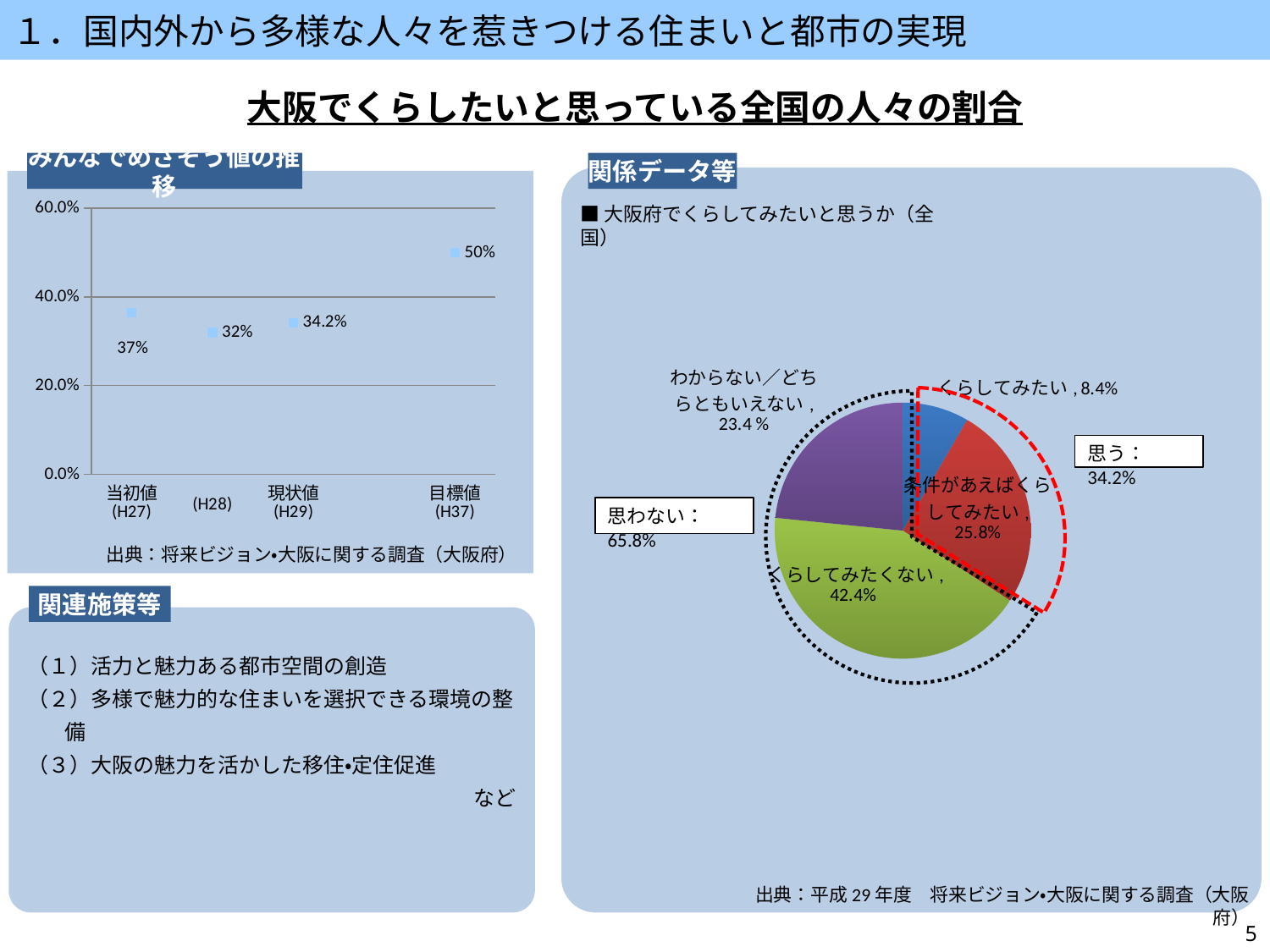
What kind of chart is shown on the right side of the slide? Pie chart In the right pie chart (大阪府でくらしてみたいと思うか), what is the combined share of くらしてみたい and 条件があえばくらしてみたい? 34.2% In the left chart (みんなでめざそう値の推移), what is the difference between the 目標値 (H37) value and the 現状値 (H29) value? 15.8% In the right pie chart (大阪府でくらしてみたいと思うか), what is the share for くらしてみたくない? 42.4% In the left chart (みんなでめざそう値の推移), how many data points are plotted? 4 In the left chart (みんなでめざそう値の推移), what is the value for 目標値 (H37)? 50% In the left chart (みんなでめざそう値の推移), which category has the highest value? 目標値 (H37) In the right pie chart (大阪府でくらしてみたいと思うか), which slice is the smallest? くらしてみたい In the left chart (みんなでめざそう値の推移), which category has the lowest value? H28 In the left chart (みんなでめざそう値の推移), what is the value for 当初値 (H27)? 37% In the right pie chart (大阪府でくらしてみたいと思うか), what is the share for 条件があえばくらしてみたい? 25.8% In the left chart (みんなでめざそう値の推移), what is the value for 現状値 (H29)? 34.2%